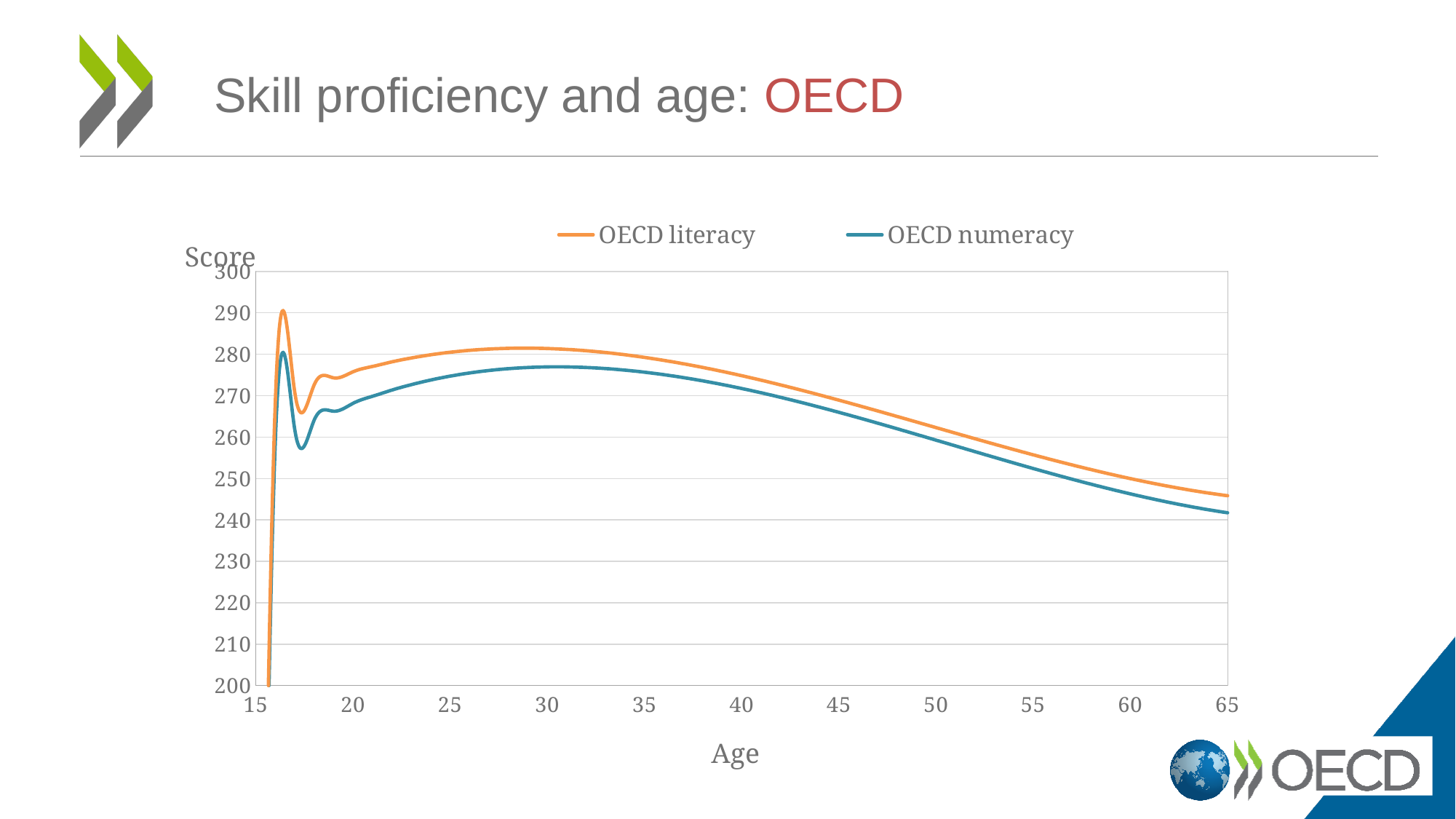
How many series does the legend list? 2 What kind of chart is shown on the slide? line chart Is the value for OECD literacy at age 65 greater or less than 240? greater What is the label of the horizontal axis? Age Is the value for OECD numeracy at age 60 greater or less than 240? greater At age 40, which series has the higher score, OECD literacy or OECD numeracy? OECD literacy What are the two series named in the legend? OECD literacy and OECD numeracy Is the value for OECD literacy at age 50 greater or less than 260? greater Which series reaches the highest score anywhere on the chart? OECD literacy Do the scores for OECD numeracy rise or fall between age 35 and age 65? fall